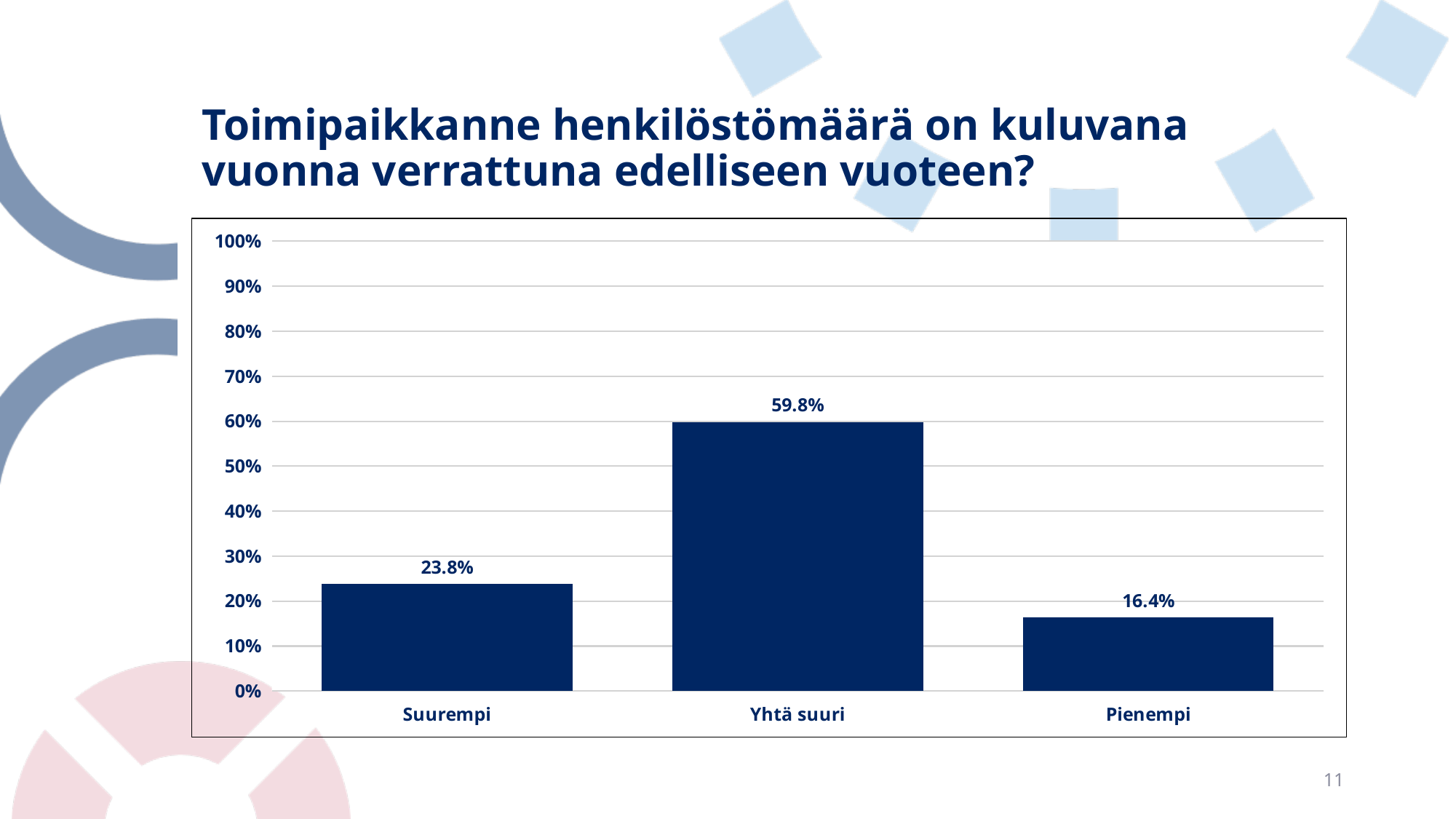
What is the difference between the values for Yhtä suuri and Suurempi? 36.0% Which is larger, the value for Suurempi or the value for Pienempi? Suurempi What is the value for Yhtä suuri? 59.8% What is the difference between the values for Suurempi and Pienempi? 7.4% What is the value for Pienempi? 16.4% What kind of chart is shown on the slide? Bar chart What is the value for Suurempi? 23.8% Which category has the lowest value? Pienempi How many categories are shown on the x axis? 3 Which category has the highest value? Yhtä suuri What is the maximum value shown on the y axis? 100% Is the value for Yhtä suuri greater or less than 50%? greater